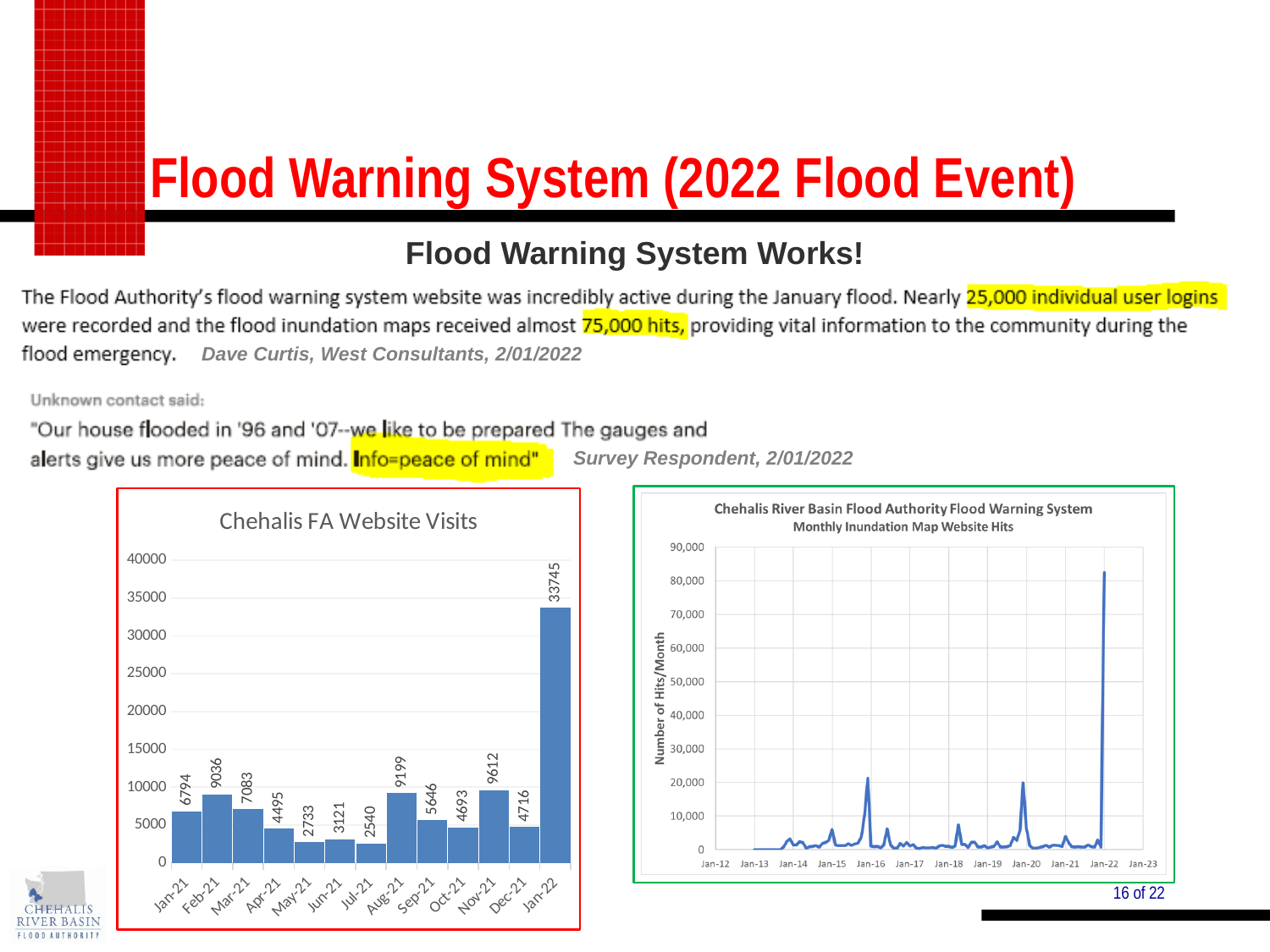
In the 'Chehalis FA Website Visits' chart, what is the value for Aug-21? 9199 In the 'Chehalis FA Website Visits' chart, which is larger, the value for Feb-21 or the value for Mar-21? Feb-21 In the 'Chehalis FA Website Visits' chart, which month has the lowest number of visits? Jul-21 In the 'Chehalis FA Website Visits' chart, what is the difference between the values for May-21 and Jun-21? 388 What kind of chart is the 'Chehalis FA Website Visits' chart? Bar chart What is the y-axis label of the 'Monthly Inundation Map Website Hits' chart on the right? Number of Hits/Month How many months are shown in the 'Chehalis FA Website Visits' chart? 13 In the 'Chehalis FA Website Visits' chart, what is the difference between the values for Jan-22 and Nov-21? 24133 In the 'Chehalis FA Website Visits' chart, what is the value for Jan-22? 33745 In the 'Chehalis FA Website Visits' chart, which month has the highest number of visits? Jan-22 In the 'Monthly Inundation Map Website Hits' chart on the right, is the peak value near Jan-22 greater or less than 80,000? greater What kind of chart is the 'Monthly Inundation Map Website Hits' chart on the right? Line chart